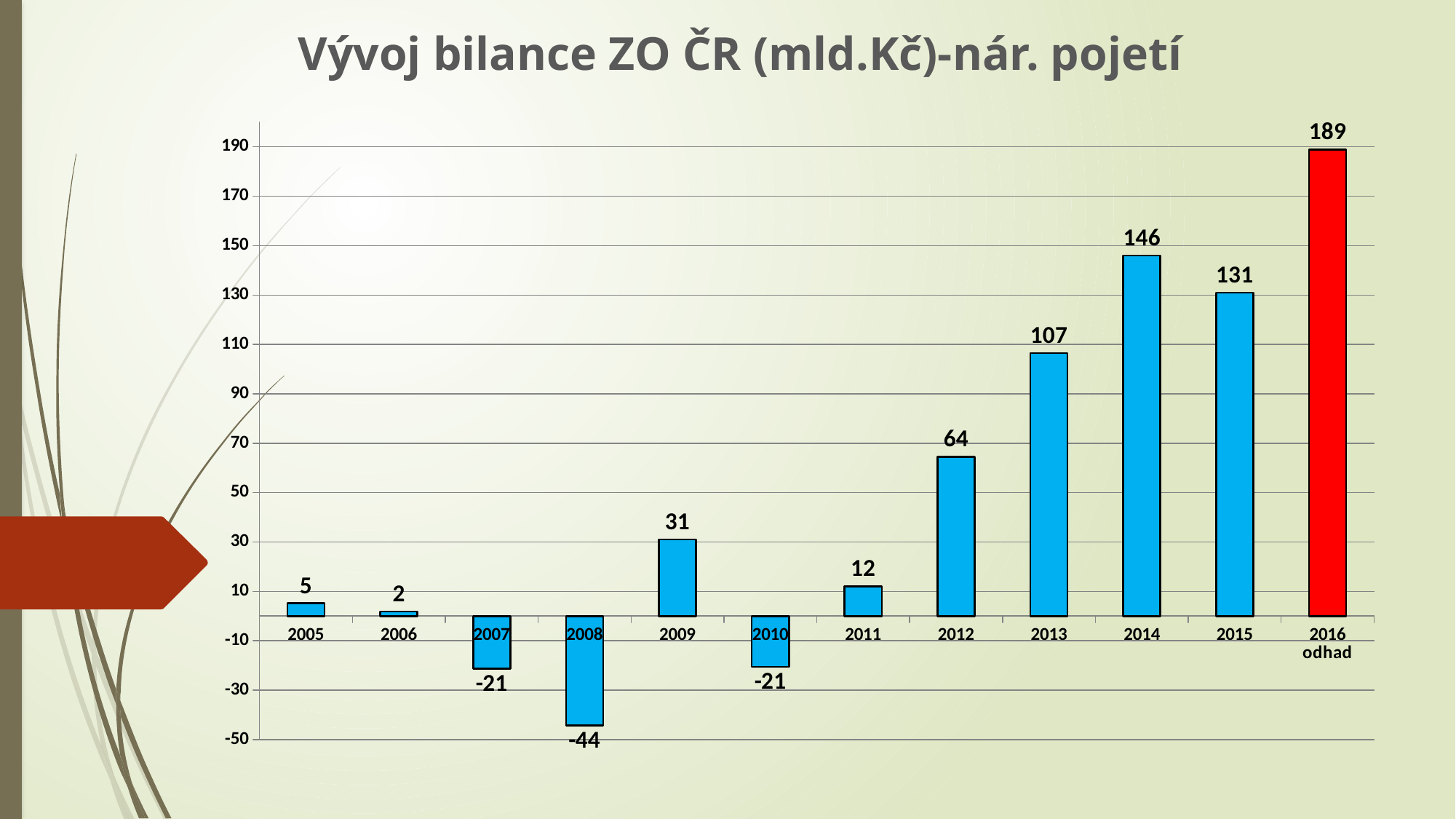
What is the difference between the values for 2014 and 2015? 15 What is the value for 2014? 146 Which is larger, the value for 2012 or the value for 2013? 2013 Which year has the highest value? 2016 odhad How many years are shown on the x axis? 12 What is the value for 2008? -44 What kind of chart is this? bar chart Is the value for 2013 greater or less than 90? greater What colour is the bar for 2016 odhad? red What is the value shown for 2016 odhad? 189 Do the values generally rise or fall from 2011 to 2014? rise Which year has the lowest value? 2008